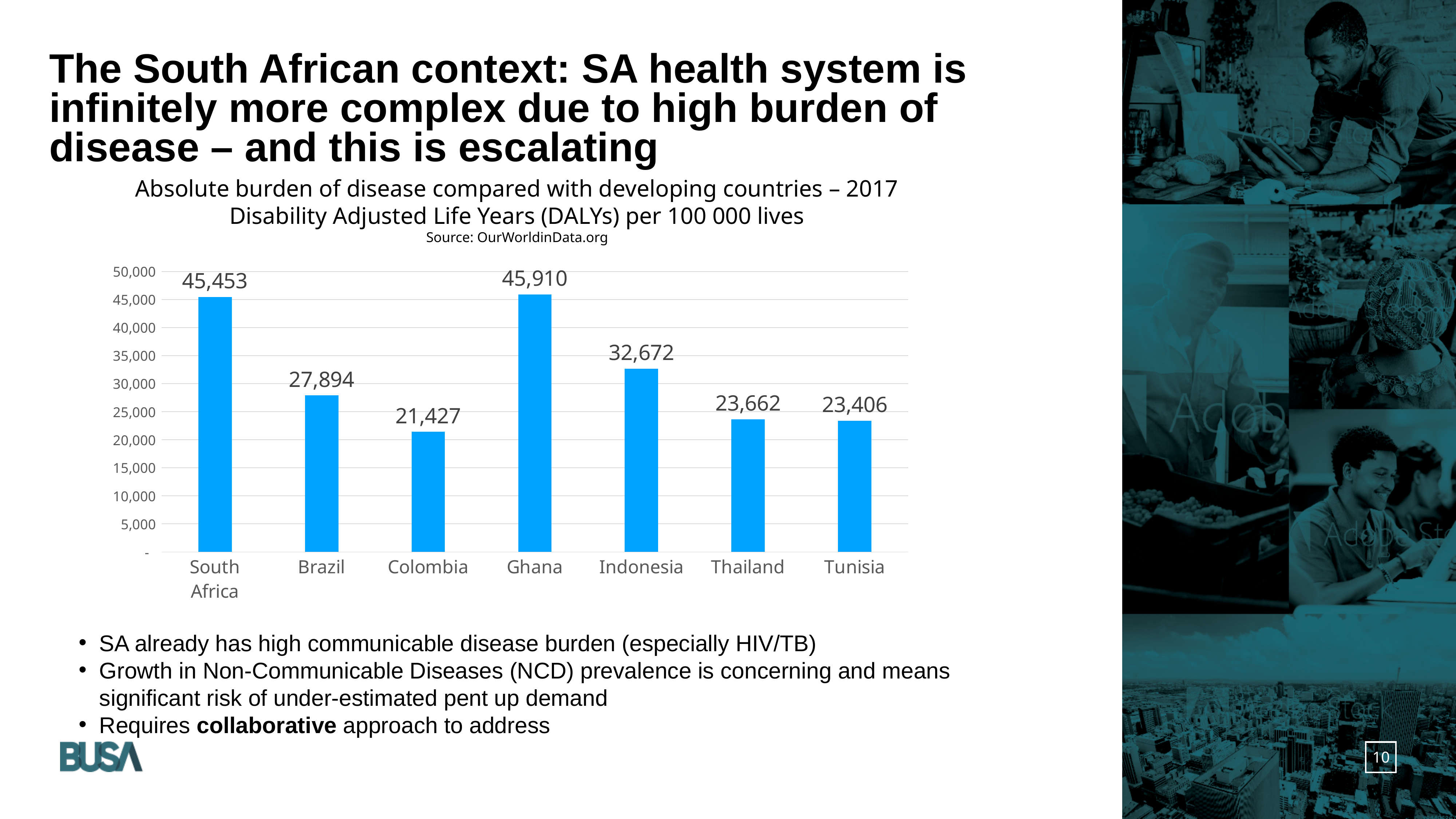
How many countries are shown in the chart? 7 What kind of chart is shown on the slide? bar chart What is the DALYs per 100 000 lives value for South Africa? 45,453 Is the value for Thailand greater or less than 25,000? less What is the difference between the values for Brazil and Colombia? 6,467 What is the value shown for Colombia? 21,427 What source is cited for the chart data? OurWorldinData.org What is the value shown for Indonesia? 32,672 What is the difference between the values for Ghana and South Africa? 457 Which is larger, the value for Brazil or the value for Indonesia? Indonesia Which country has the highest value in the chart? Ghana Which country has the lowest value in the chart? Colombia